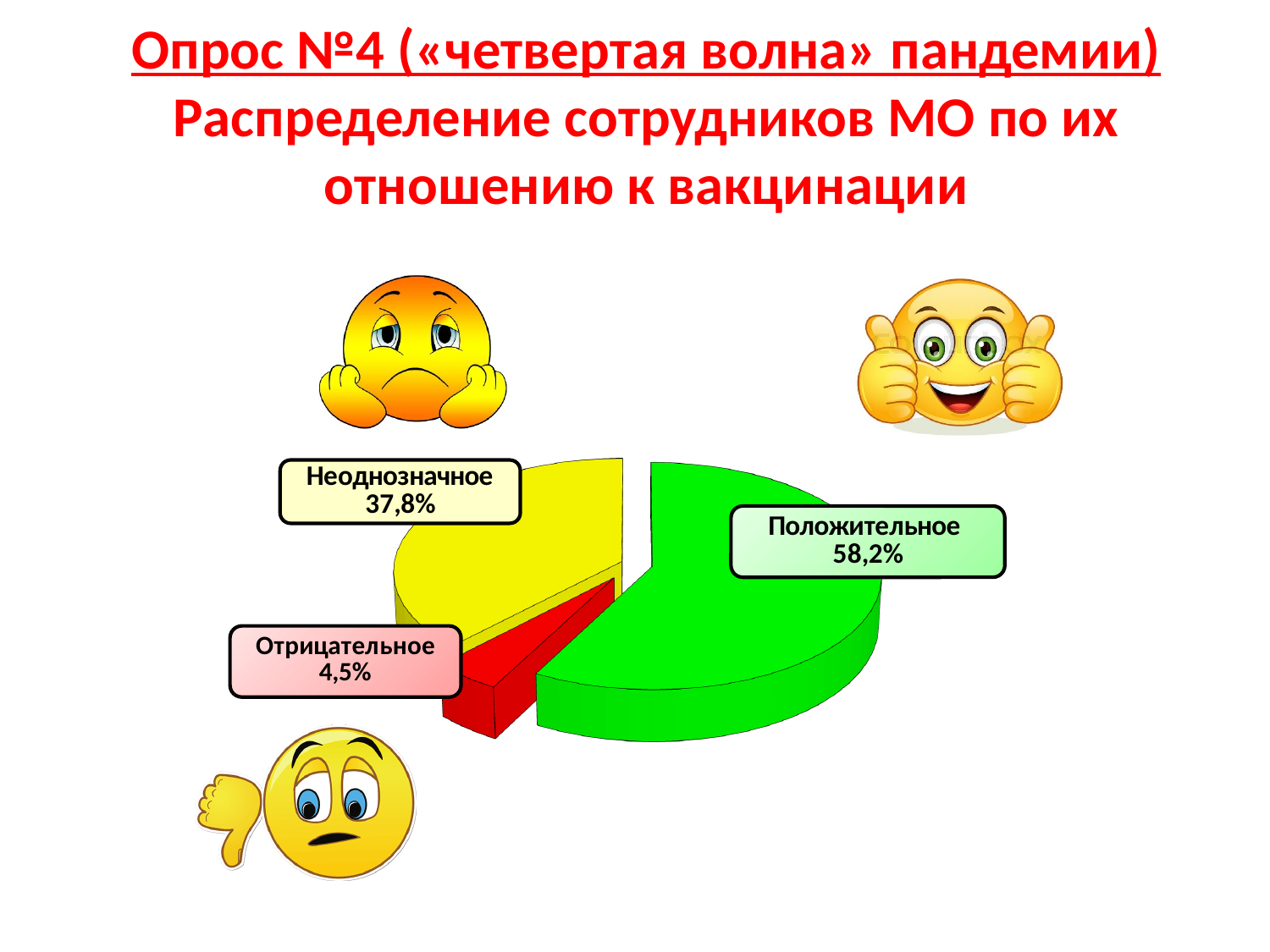
What share of employees have a negative (Отрицательное) attitude to vaccination? 4,5% Which category has the largest share of the pie? Положительное What is the difference in percentage points between the Положительное and Неоднозначное shares? 20,4 How many categories (slices) does the pie chart have? 3 What share of employees have an ambiguous (Неоднозначное) attitude to vaccination? 37,8% Which category has the smallest share of the pie? Отрицательное What colour is the slice for Положительное? green What share of employees have a positive (Положительное) attitude to vaccination? 58,2% Which is larger: the share for Неоднозначное or the share for Отрицательное? Неоднозначное What colour is the slice for Отрицательное? red What is the difference in percentage points between the Неоднозначное and Отрицательное shares? 33,3 What kind of chart is shown on the slide? pie chart